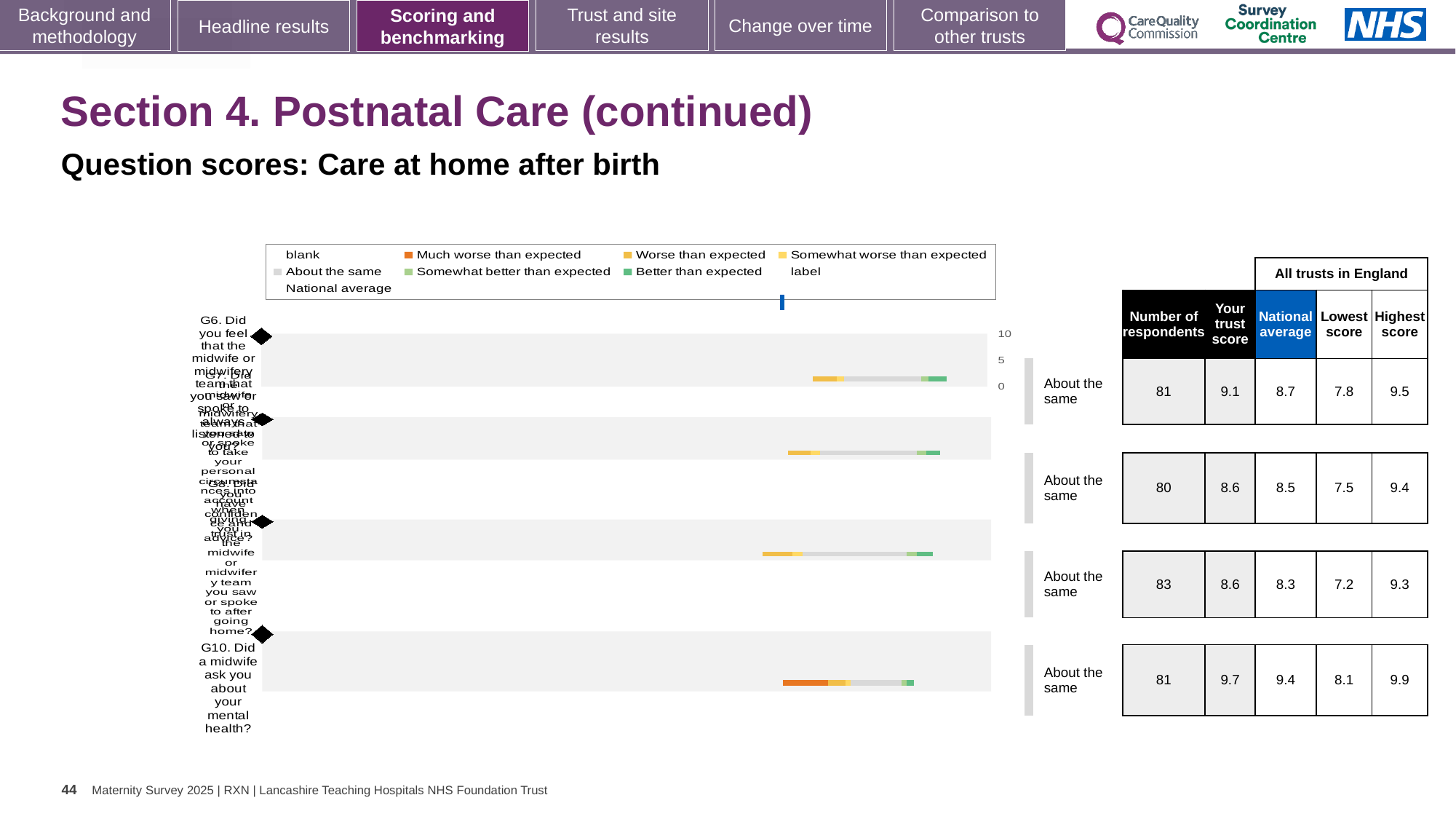
Which question row has the highest 'Your trust score'? G10 (9.7) What is the national average for G10 (Did a midwife ask you about your mental health?)? 9.4 What is the 'Your trust score' for the first row (G6)? 9.1 What is the lowest score among all trusts in England for the first row (G6)? 7.8 By how much does the trust score for G10 exceed the national average for G10? 0.3 How many respondents are listed for G10 (Did a midwife ask you about your mental health?)? 81 What kind of chart is shown on the slide? bar chart What is the highest score among all trusts in England for G10? 9.9 How many question rows (bars) does the chart show? 4 For G10, which is larger: the trust score or the national average? the trust score (9.7) What is the 'Your trust score' for G10 (Did a midwife ask you about your mental health?)? 9.7 What benchmark category label is shown next to the G10 bar? About the same